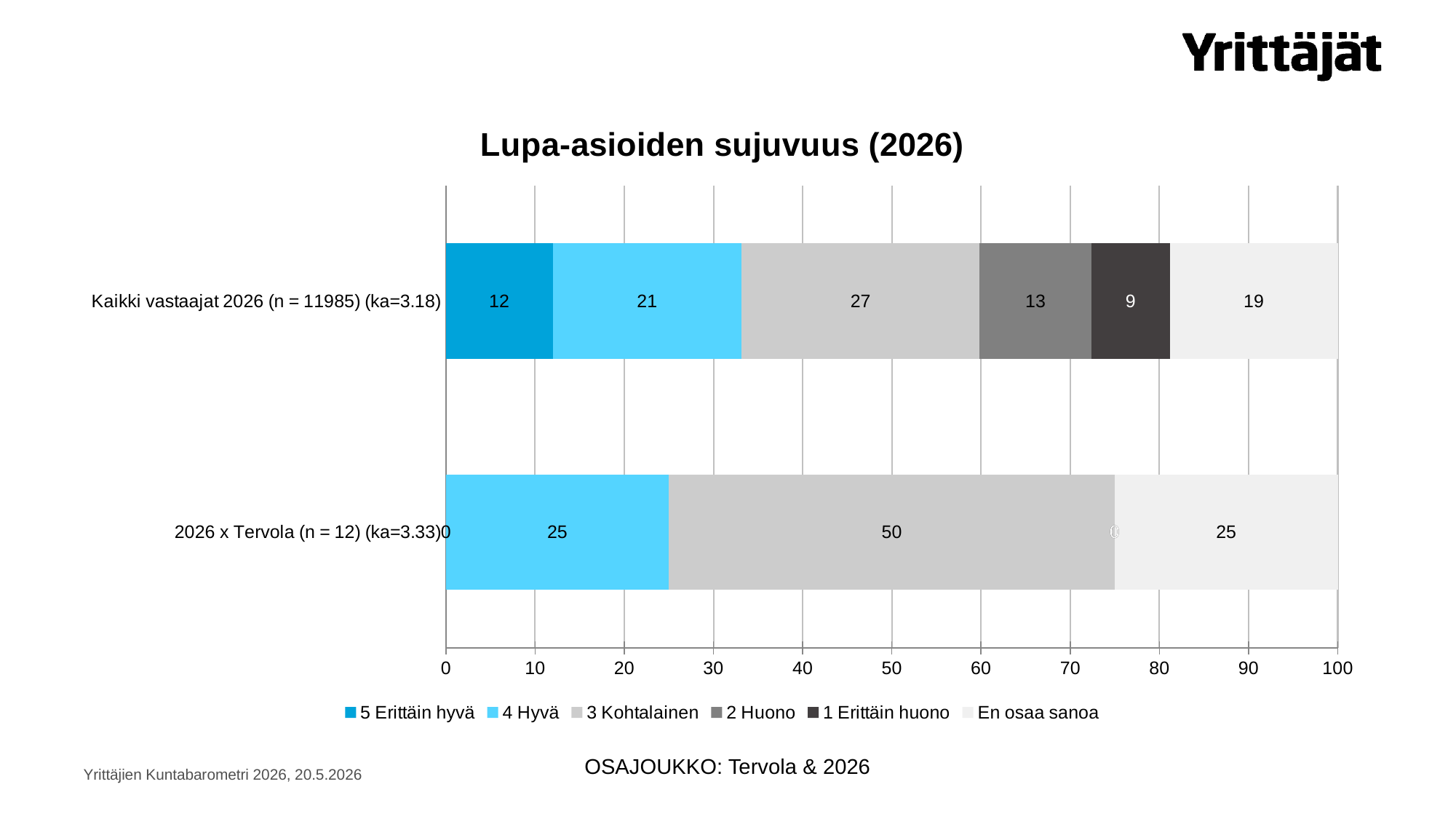
What is the value of "4 Hyvä" for "2026 x Tervola (n = 12) (ka=3.33)"? 25 What is the difference between the "3 Kohtalainen" values for "2026 x Tervola (n = 12) (ka=3.33)" and "Kaikki vastaajat 2026 (n = 11985) (ka=3.18)"? 23 Which is larger: the "4 Hyvä" value for "Kaikki vastaajat 2026 (n = 11985) (ka=3.18)" or for "2026 x Tervola (n = 12) (ka=3.33)"? 2026 x Tervola (n = 12) (ka=3.33) Which series has the smallest non-zero value in the "Kaikki vastaajat 2026 (n = 11985) (ka=3.18)" bar? 1 Erittäin huono What is the value of "3 Kohtalainen" for "Kaikki vastaajat 2026 (n = 11985) (ka=3.18)"? 27 What is the value of "1 Erittäin huono" for "Kaikki vastaajat 2026 (n = 11985) (ka=3.18)"? 9 How many categories (bars) are shown in the chart? 2 Which series has the largest value in the "2026 x Tervola (n = 12) (ka=3.33)" bar? 3 Kohtalainen What kind of chart is shown on the slide? Stacked bar chart What is the value of "En osaa sanoa" for "2026 x Tervola (n = 12) (ka=3.33)"? 25 How many series does the legend list? 6 What is the title of the chart? Lupa-asioiden sujuvuus (2026)